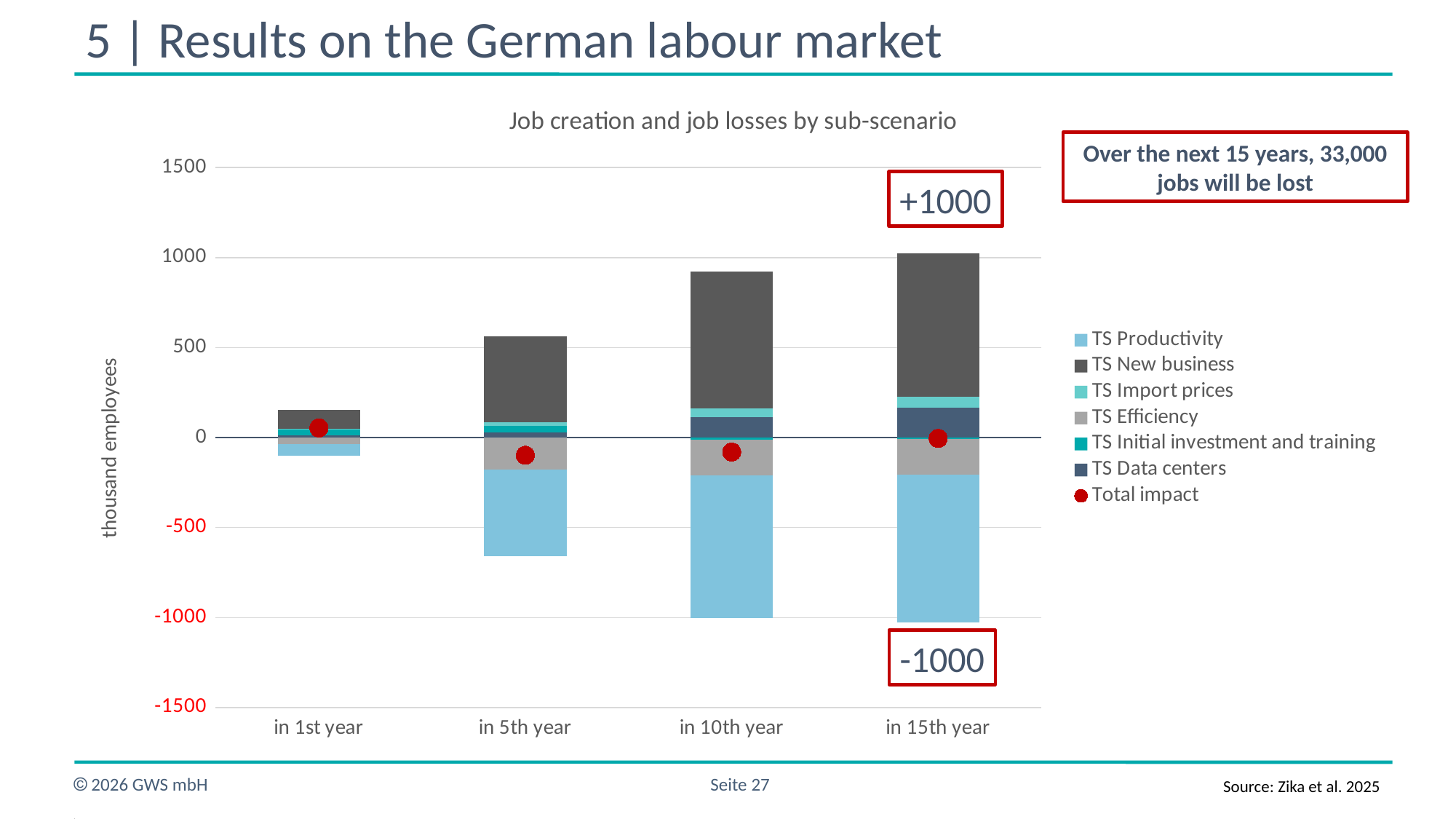
What is the title of the chart? Job creation and job losses by sub-scenario In which year is the positive (above zero) stacked bar the shortest? in 1st year What is the label on the vertical axis of the chart? thousand employees In which year is the positive (above zero) stacked bar the tallest? in 15th year What kind of chart is shown on the slide? Stacked bar chart Is the top of the TS New business segment in the 5th year greater or less than 500? greater How many year categories are shown on the x axis of the chart? 4 How many entries does the chart legend list? 7 Does the height of the positive stacked bar rise or fall from the 1st year to the 15th year? Rise Which is higher, the Total impact marker in the 1st year or in the 5th year? in 1st year Is the top of the TS New business segment in the 10th year greater or less than 1000? less